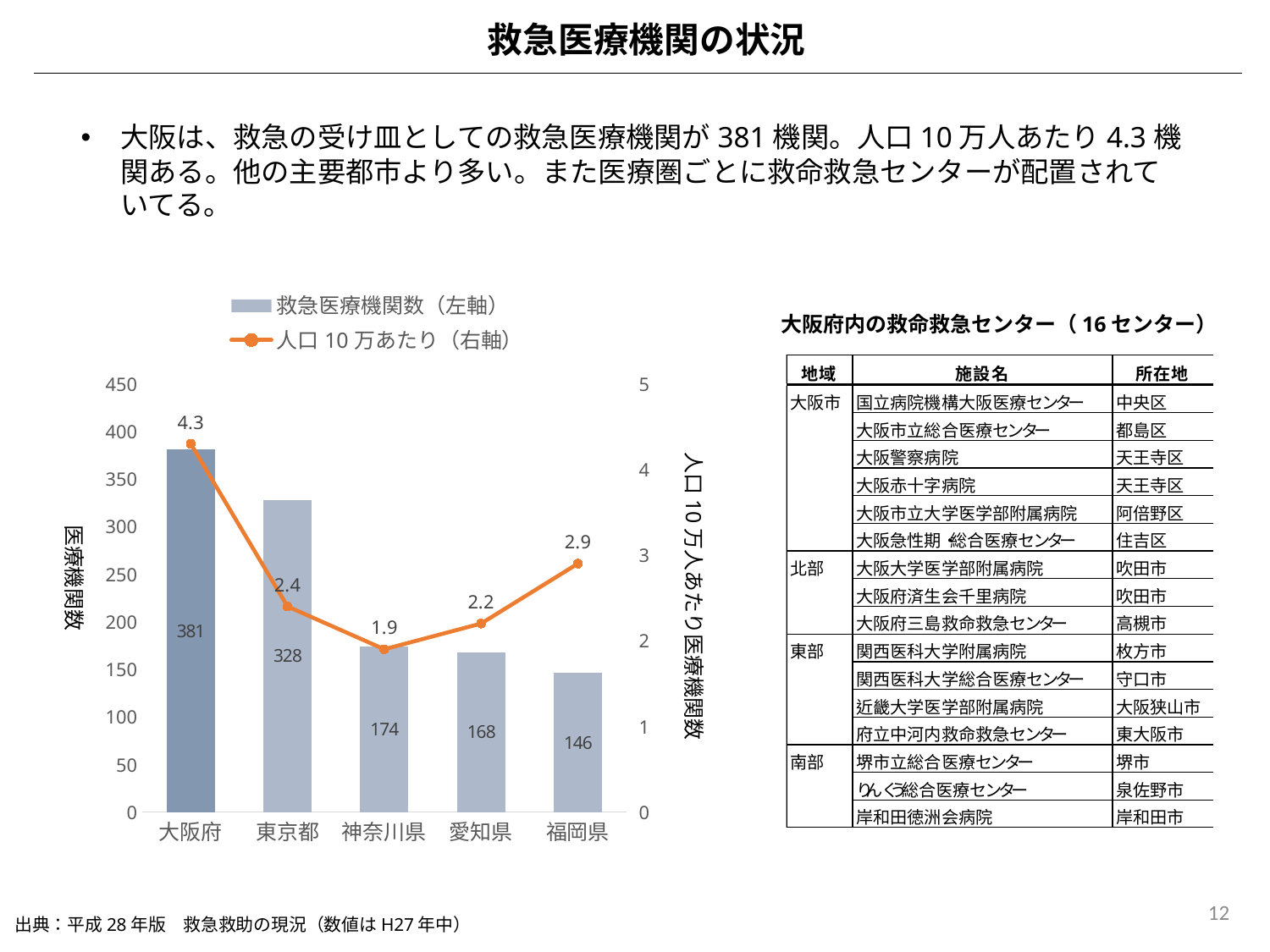
What is the value of 人口10万あたり for 神奈川県? 1.9 How many series does the chart legend list? 2 Which has a higher 人口10万あたり value, 愛知県 or 福岡県? 福岡県 Which series in the chart is plotted as a line with markers? 人口10万あたり（右軸） What is the value of 人口10万あたり for 福岡県? 2.9 How many prefectures are shown on the x axis of the chart? 5 What is the difference in 救急医療機関数 between 大阪府 and 東京都? 53 What is the number of emergency medical institutions (救急医療機関数) for 東京都? 328 Is the 救急医療機関数 value for 福岡県 greater or less than 150? less What is the number of emergency medical institutions (救急医療機関数) for 大阪府? 381 Which prefecture has the highest number of emergency medical institutions (救急医療機関数)? 大阪府 Which prefecture has the lowest value of 人口10万あたり? 神奈川県